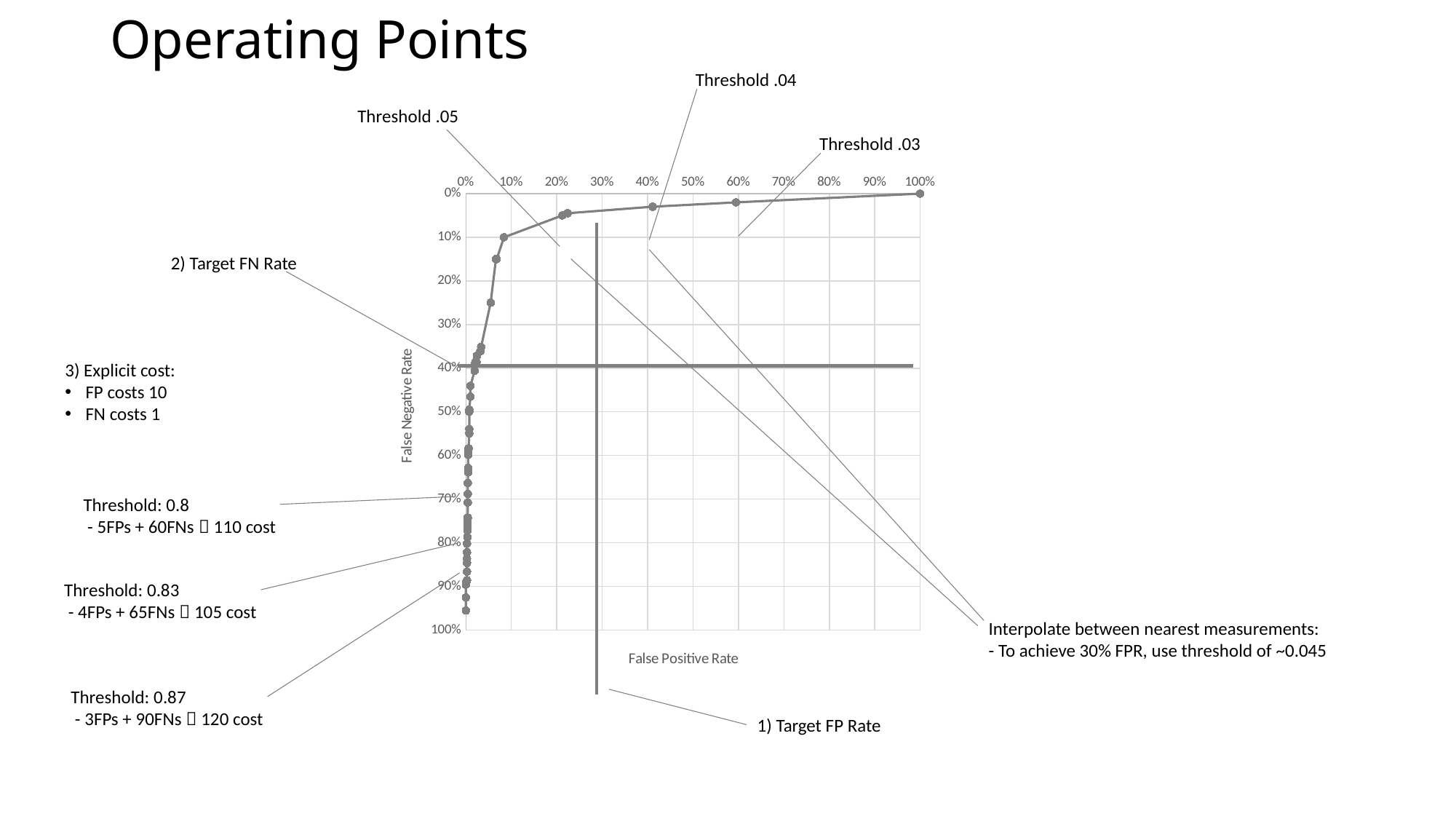
Which plotted point has the lowest False Negative Rate: the one at 100% False Positive Rate or the one at 60% False Positive Rate? the one at 100% False Positive Rate What is the label of the chart's horizontal axis? False Positive Rate What is the False Negative Rate of the plotted point at 100% False Positive Rate? 0% What is the label of the chart's vertical axis? False Negative Rate Is the False Negative Rate of the point at 40% False Positive Rate greater or less than 10%? less Is the False Negative Rate of the point at 60% False Positive Rate greater or less than 10%? less At what False Negative Rate is the horizontal 'Target FN Rate' line drawn on the chart? 40% According to the annotations, what is the cost at threshold 0.83? 105 According to the annotation, what threshold should be used to achieve a 30% FPR? ~0.045 What is the title of the slide containing the chart? Operating Points As the False Positive Rate increases along the x axis, does the False Negative Rate rise or fall? fall